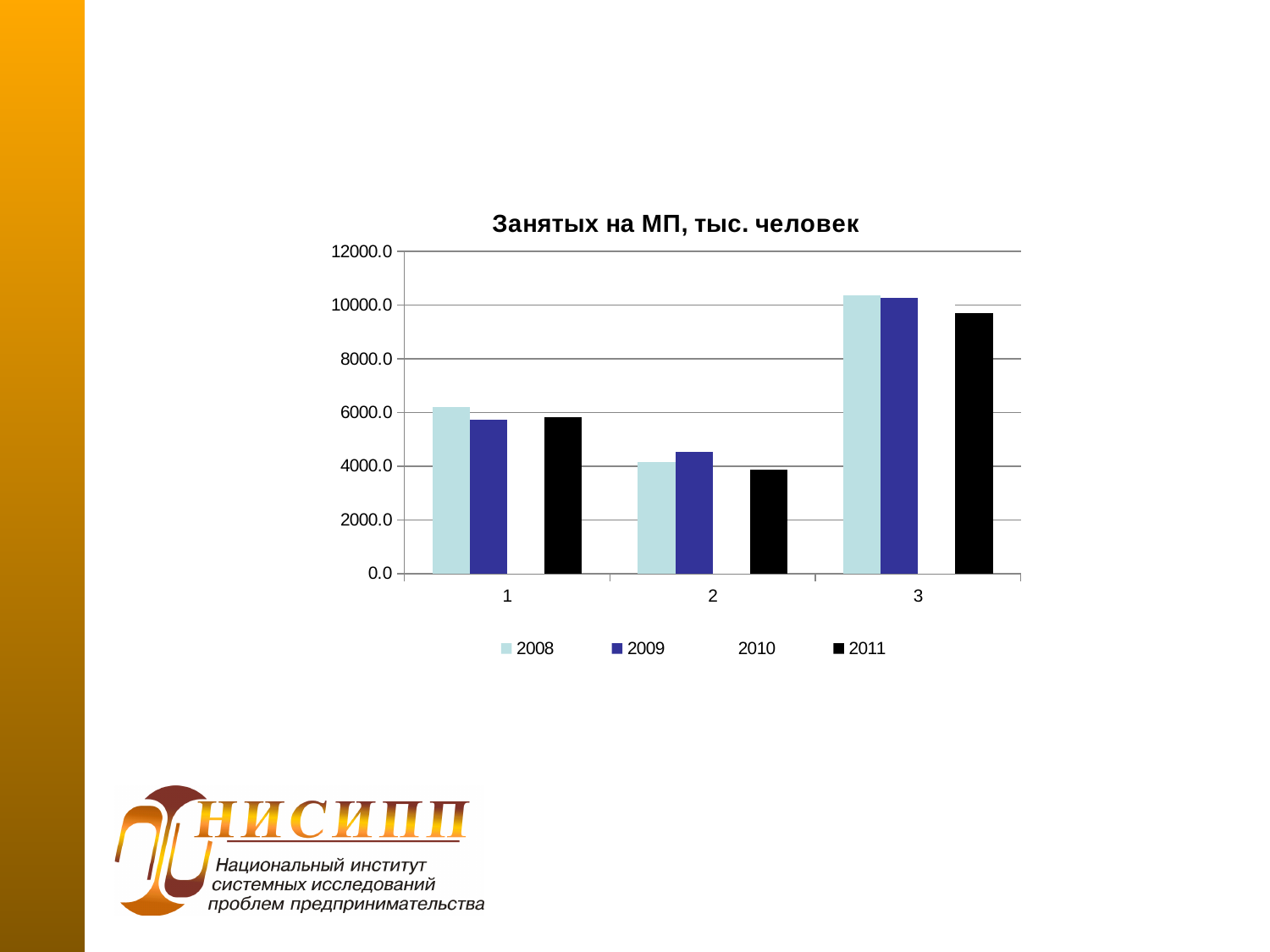
How many series does the legend list? 4 In category 3, which is larger: the 2008 value or the 2011 value? 2008 Is the 2008 value for category 1 greater or less than 6000.0? greater Which category has the highest values across the series? 3 What is the title of the chart? Занятых на МП, тыс. человек Which category has the lowest values across the series? 2 How many categories are shown on the x axis? 3 Is the 2008 value for category 3 greater or less than 10000.0? greater In category 2, which is larger: the 2008 value or the 2009 value? 2009 What kind of chart is shown on the slide? bar chart Is the 2011 value for category 3 greater or less than 10000.0? less